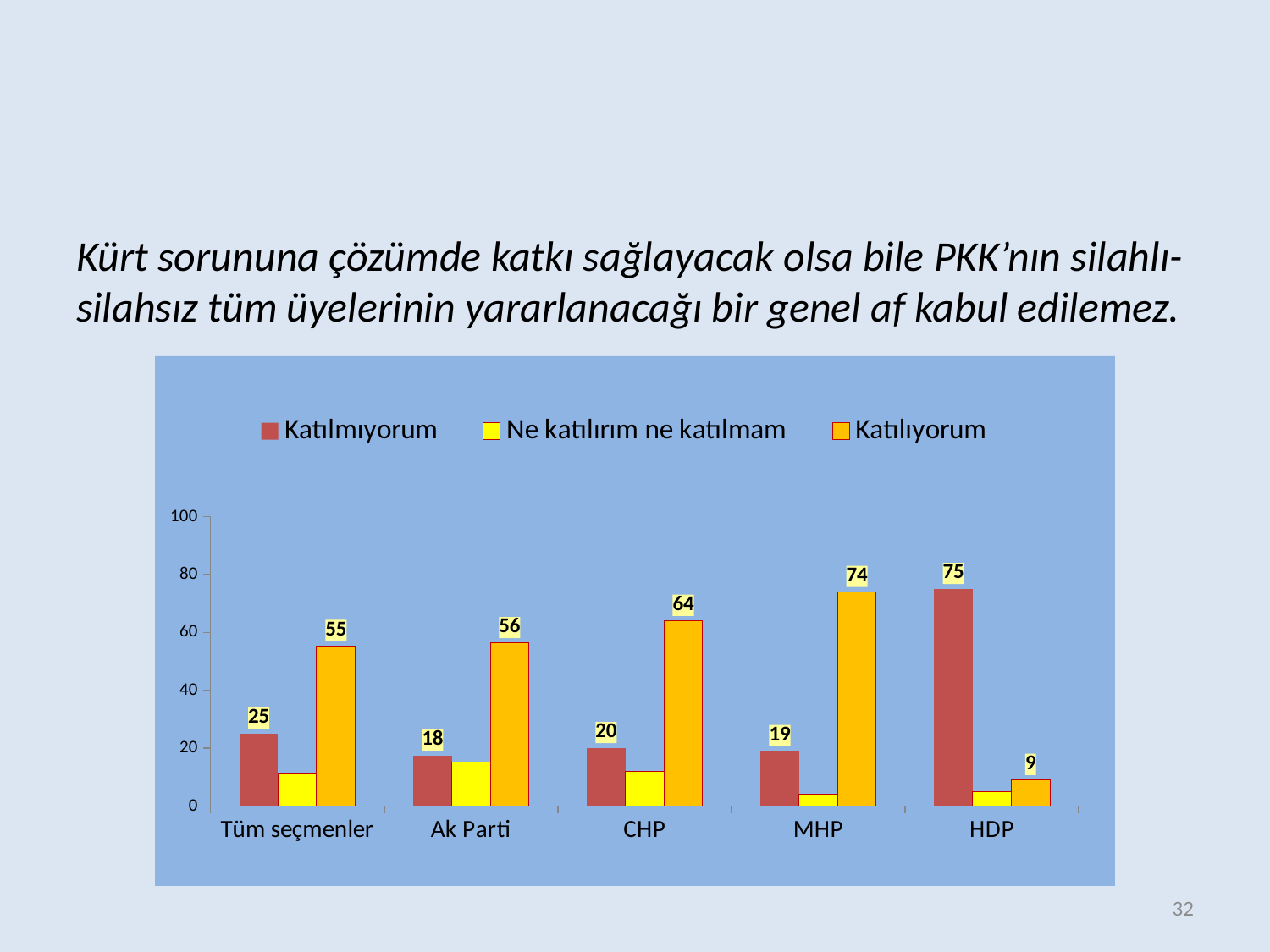
What kind of chart is shown on the slide? bar chart How many categories are shown on the x axis? 5 Which series is shown in red? Katılmıyorum Which is larger: the Katılmıyorum value for Tüm seçmenler or the Katılmıyorum value for CHP? Tüm seçmenler Is the Ne katılırım ne katılmam value for Tüm seçmenler greater or less than 20? less Which category has the highest Katılıyorum value? MHP Which category has the lowest Katılmıyorum value? Ak Parti What is the Katılıyorum value for CHP? 64 What is the Katılmıyorum value for HDP? 75 How many series does the legend list? 3 What is the difference between the Katılıyorum values for MHP and HDP? 65 What is the Katılıyorum value for Tüm seçmenler? 55